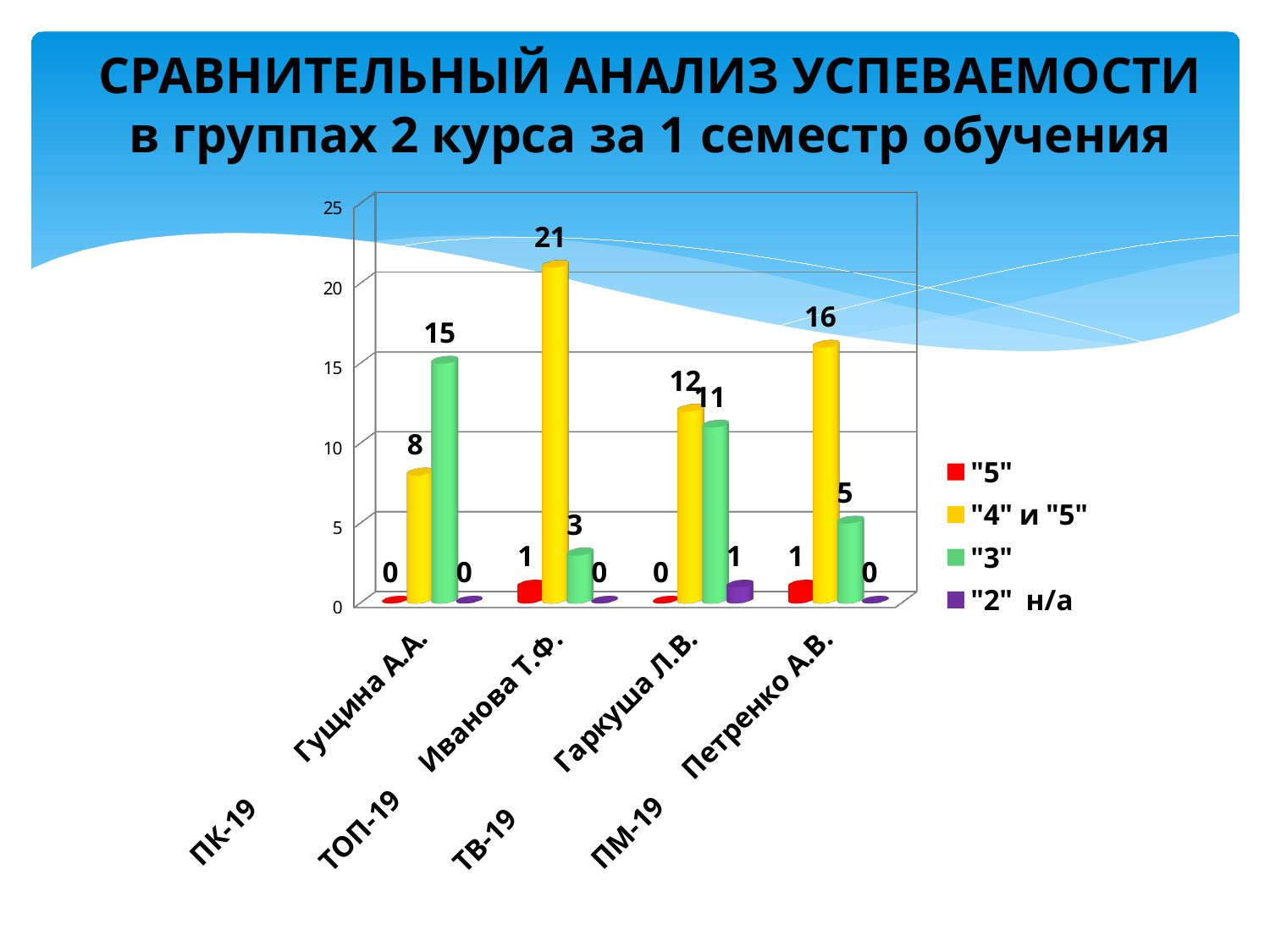
What is the value of the "4" и "5" series for ТОП-19 Иванова Т.Ф.? 21 What is the difference between the "4" и "5" values for ТОП-19 Иванова Т.Ф. and ПМ-19 Петренко А.В.? 5 How many series does the legend list? 4 For ТВ-19 Гаркуша Л.В., which is larger: the "4" и "5" value or the "3" value? "4" и "5" How many groups (categories) are shown on the x axis? 4 What colour represents the "3" series in the legend? Green What is the value of the "2" н/а series for ТВ-19 Гаркуша Л.В.? 1 Which group has the highest value in the "4" и "5" series? ТОП-19 Иванова Т.Ф. What is the value of the "3" series for ПК-19 Гущина А.А.? 15 What is the value of the "5" series for ПМ-19 Петренко А.В.? 1 What kind of chart is shown on the slide? Bar chart Which group has the lowest value in the "3" series? ТОП-19 Иванова Т.Ф.